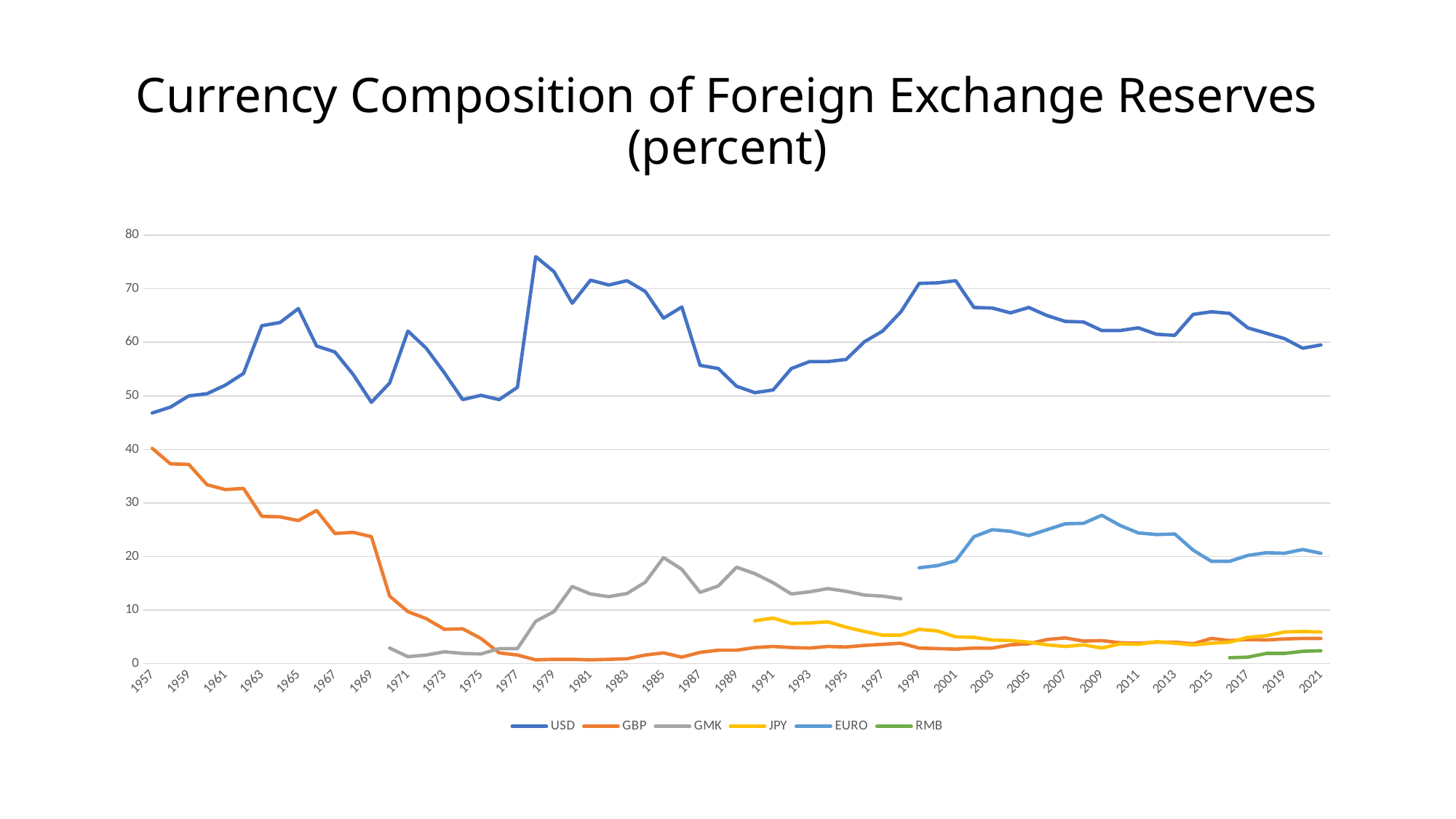
Which series is drawn in green? RMB Which is larger in 1957, USD or GBP? USD Is the value for GBP in 1957 greater or less than 30? greater What kind of chart is shown on the slide? line chart Is the value for USD in 1957 greater or less than 50? less Does the GBP series rise or fall from 1957 to 1977? fall What is the title of the chart? Currency Composition of Foreign Exchange Reserves (percent) Is the value for USD in 1991 greater or less than 60? less Which series has the highest value in 2021? USD How many series does the legend list? 6